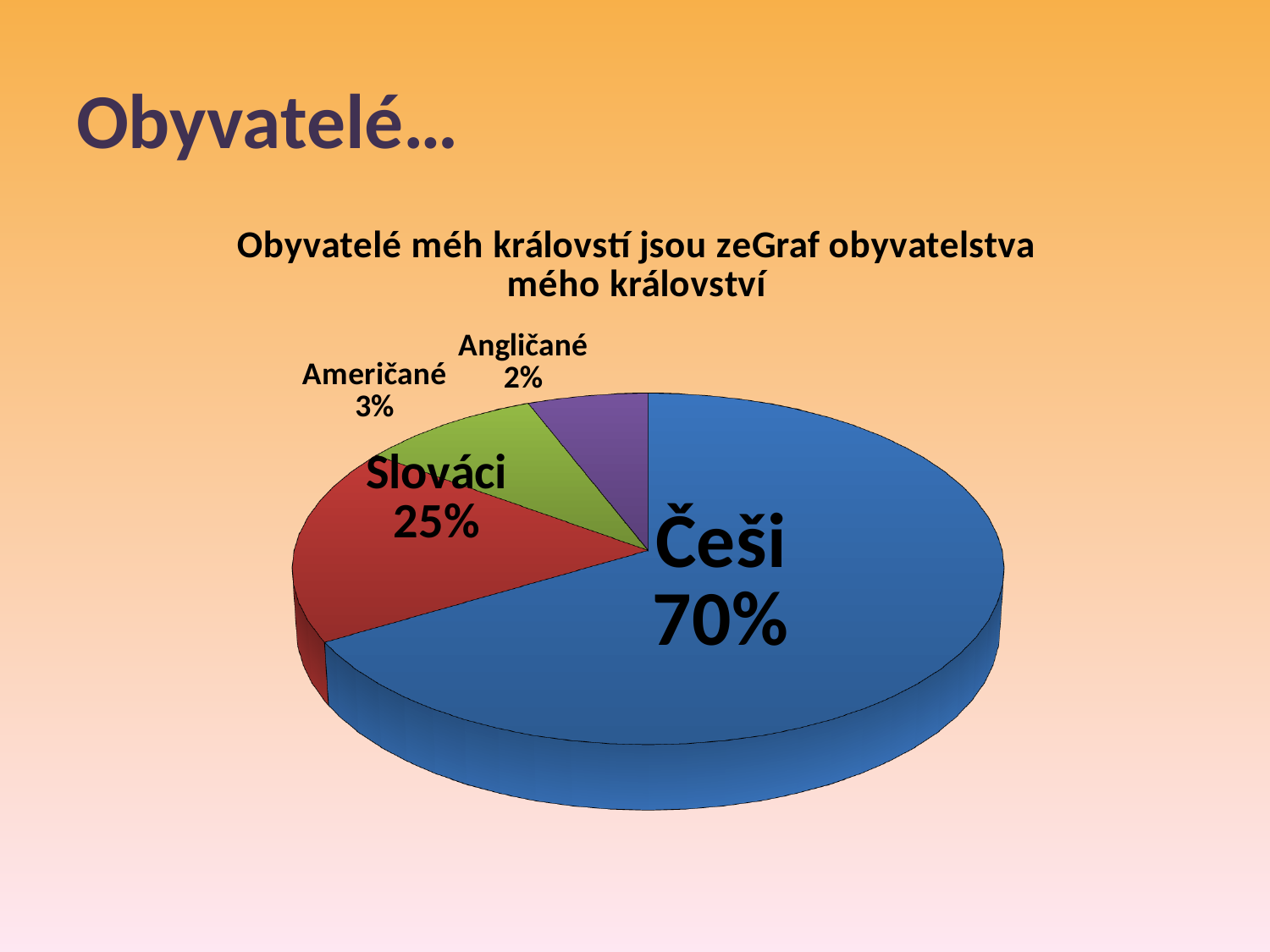
What kind of chart is shown on the slide? Pie chart What share of the pie is Češi? 70% Which group has the largest slice of the pie? Češi What share of the pie is Slováci? 25% How many slices does the pie chart have? 4 What is the difference between the shares of Američané and Angličané? 1% Which group has the smallest slice of the pie? Angličané What share of the pie is Američané? 3% Which is larger, the share of Slováci or the share of Američané? Slováci What is the difference between the shares of Češi and Slováci? 45% What colour is the Slováci slice? Red What share of the pie is Angličané? 2%